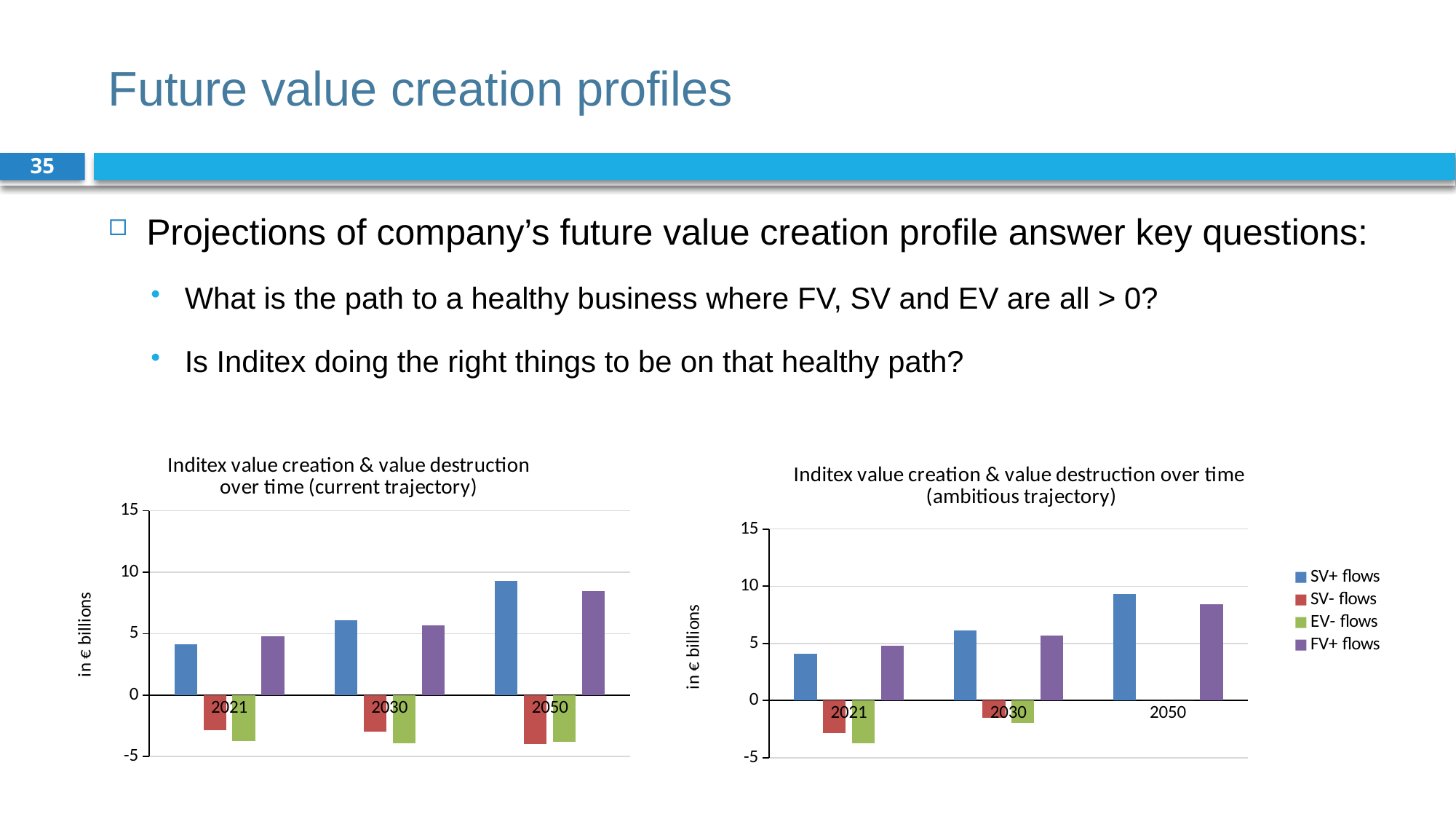
In the left chart (current trajectory), is the value for SV+ flows in 2050 greater or less than 10? less In the left chart (current trajectory), which is larger in 2050, SV+ flows or FV+ flows? SV+ flows In the right chart (ambitious trajectory), is the value for FV+ flows in 2030 greater or less than 5? greater What type of chart is the left chart titled 'Inditex value creation & value destruction over time (current trajectory)'? bar chart In the right chart (ambitious trajectory), which year has the lowest (most negative) EV- flows? 2021 In the right chart (ambitious trajectory), how many bars are plotted for 2050? 2 In the left chart (current trajectory), do the SV+ flows rise or fall from 2021 to 2050? rise In the left chart (current trajectory), which year has the highest FV+ flows? 2050 How many series does the legend list for the charts on the slide? 4 In the left chart (current trajectory), how many years are shown on the x axis? 3 In the left chart (current trajectory), is the value for SV+ flows in 2030 greater or less than 5? greater What is the y-axis label on the left chart (current trajectory)? in € billions